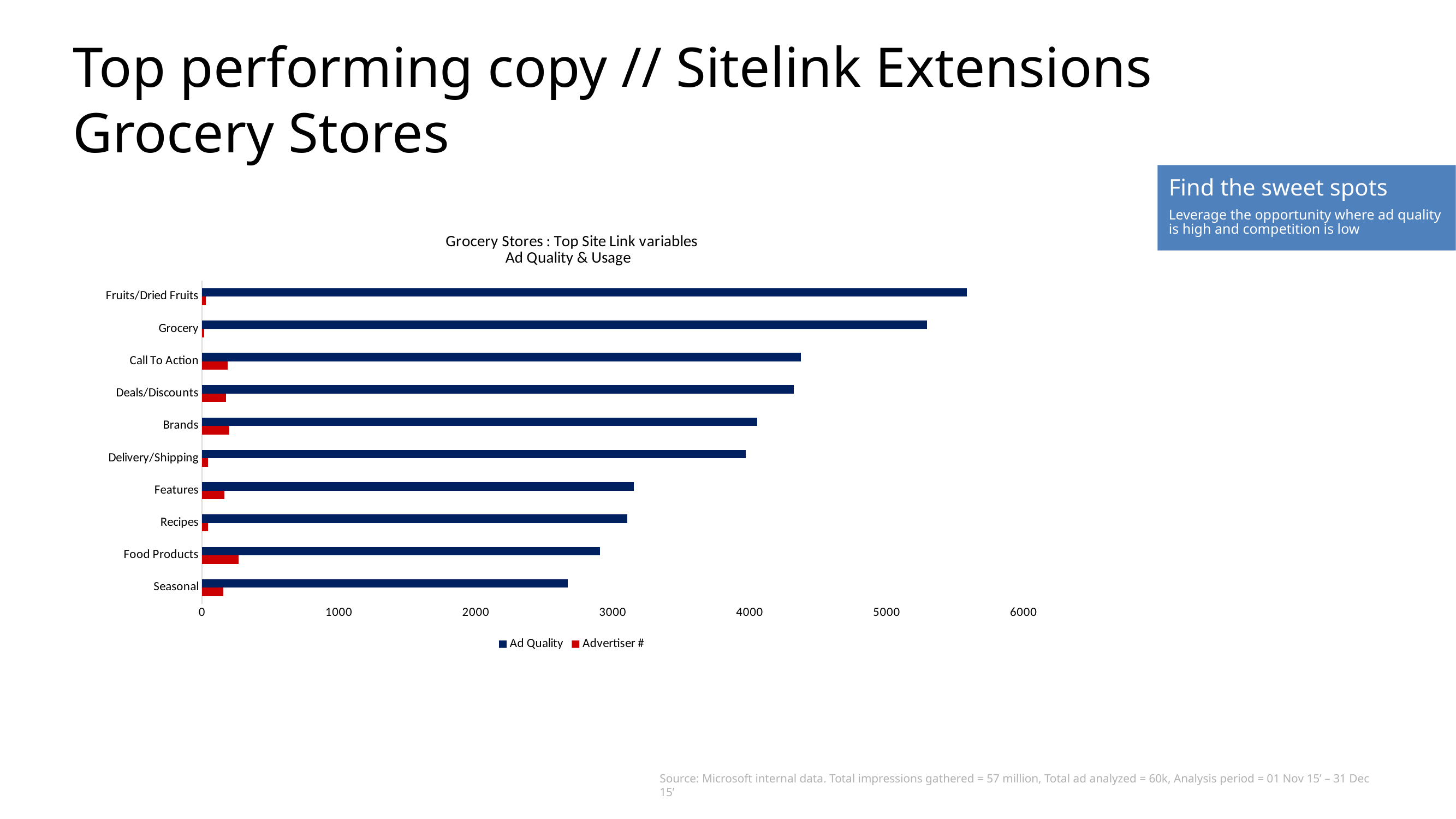
Do the Ad Quality values rise or fall going from the top category to the bottom category? fall What kind of chart is shown on the slide? bar chart Which category has the highest Ad Quality value? Fruits/Dried Fruits Which category has the lowest Ad Quality value? Seasonal Which has a larger Ad Quality value, Fruits/Dried Fruits or Grocery? Fruits/Dried Fruits Is the Ad Quality value for Fruits/Dried Fruits greater or less than 5000? greater Is the Ad Quality value for Seasonal greater or less than 3000? less Which category has the highest Advertiser # value? Food Products How many categories are plotted on the chart? 10 Is the Ad Quality value for Call To Action greater or less than 4000? greater Which series is shown in red in the chart? Advertiser # How many series does the chart legend list? 2